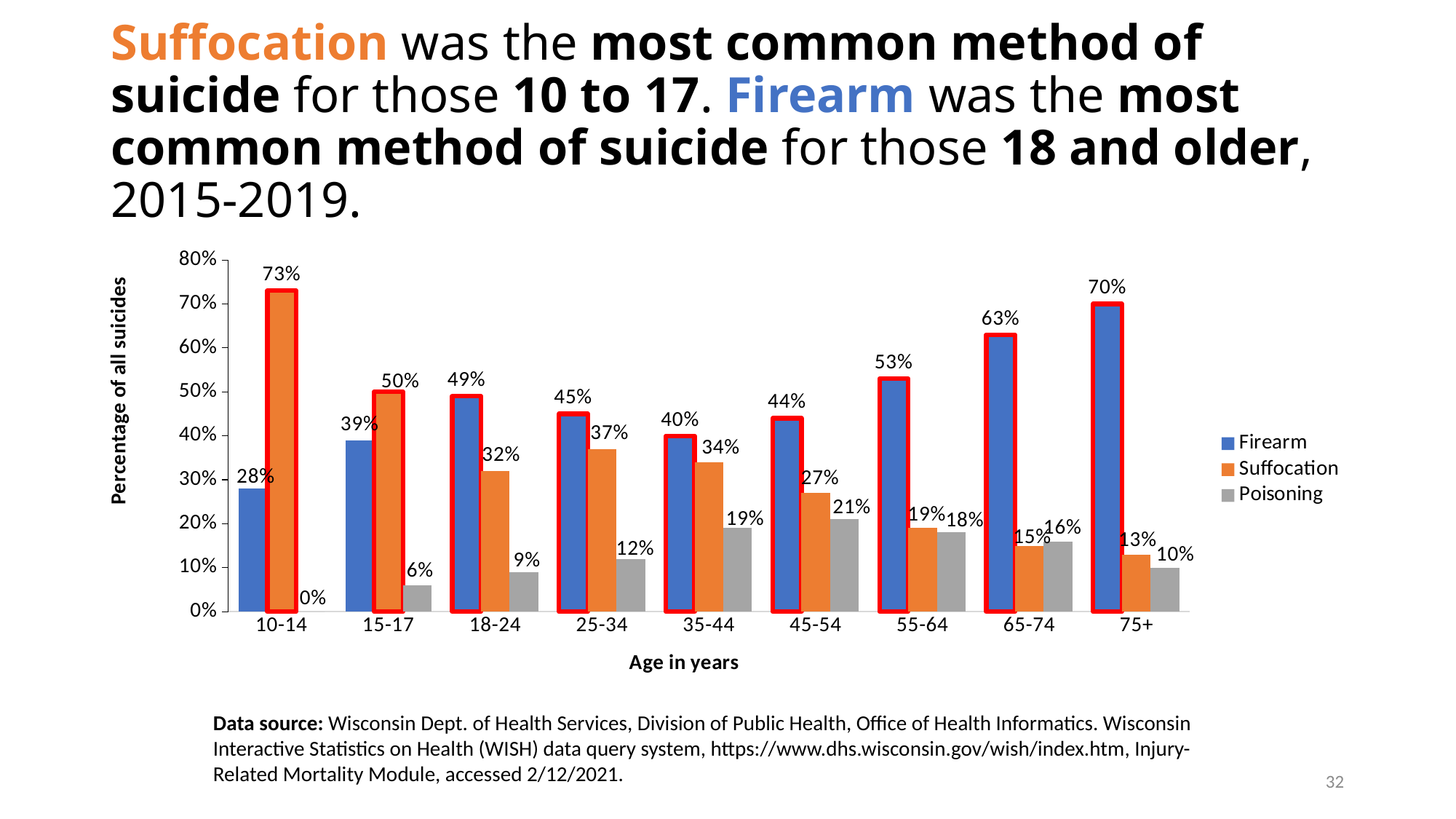
Which age group has the lowest Poisoning value? 10-14 How many series does the legend list? 3 What is the label of the y axis? Percentage of all suicides For the 15-17 age group, which is larger: Firearm or Suffocation? Suffocation How many age groups are shown on the x axis? 9 What kind of chart is shown on the slide? Bar chart What is the Suffocation value for the 10-14 age group? 73% Which age group has the highest Firearm value? 75+ What is the Poisoning value for the 45-54 age group? 21% What is the Firearm value for the 75+ age group? 70% Do the Firearm values rise or fall from the 35-44 age group to the 75+ age group? Rise What is the difference between the Firearm and Suffocation values for the 18-24 age group? 17%